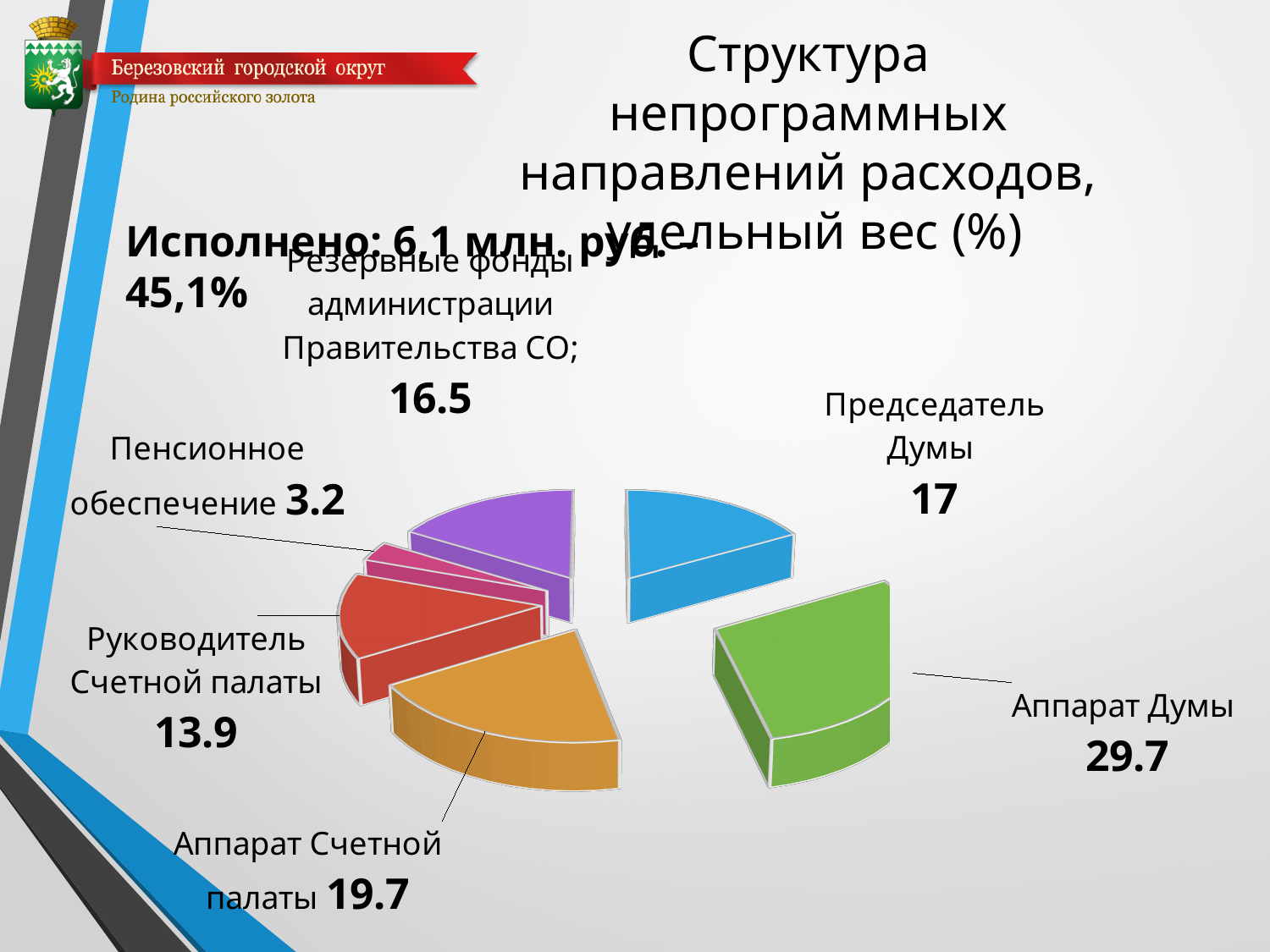
What is the value shown for Аппарат Думы? 29.7 What is the difference between the values for Аппарат Счетной палаты and Руководитель Счетной палаты? 5.8 What is the value shown for Резервные фонды администрации Правительства СО? 16.5 What is the value shown for Председатель Думы? 17 Which is larger: Аппарат Счетной палаты or Председатель Думы? Аппарат Счетной палаты Which category has the smallest share of the pie? Пенсионное обеспечение What is the value shown for Пенсионное обеспечение? 3.2 What kind of chart is shown on the slide? pie chart What is the difference between the values for Аппарат Думы and Пенсионное обеспечение? 26.5 What colour is the slice for Аппарат Думы? green How many slices does the pie chart have? 6 Which category has the largest share of the pie? Аппарат Думы